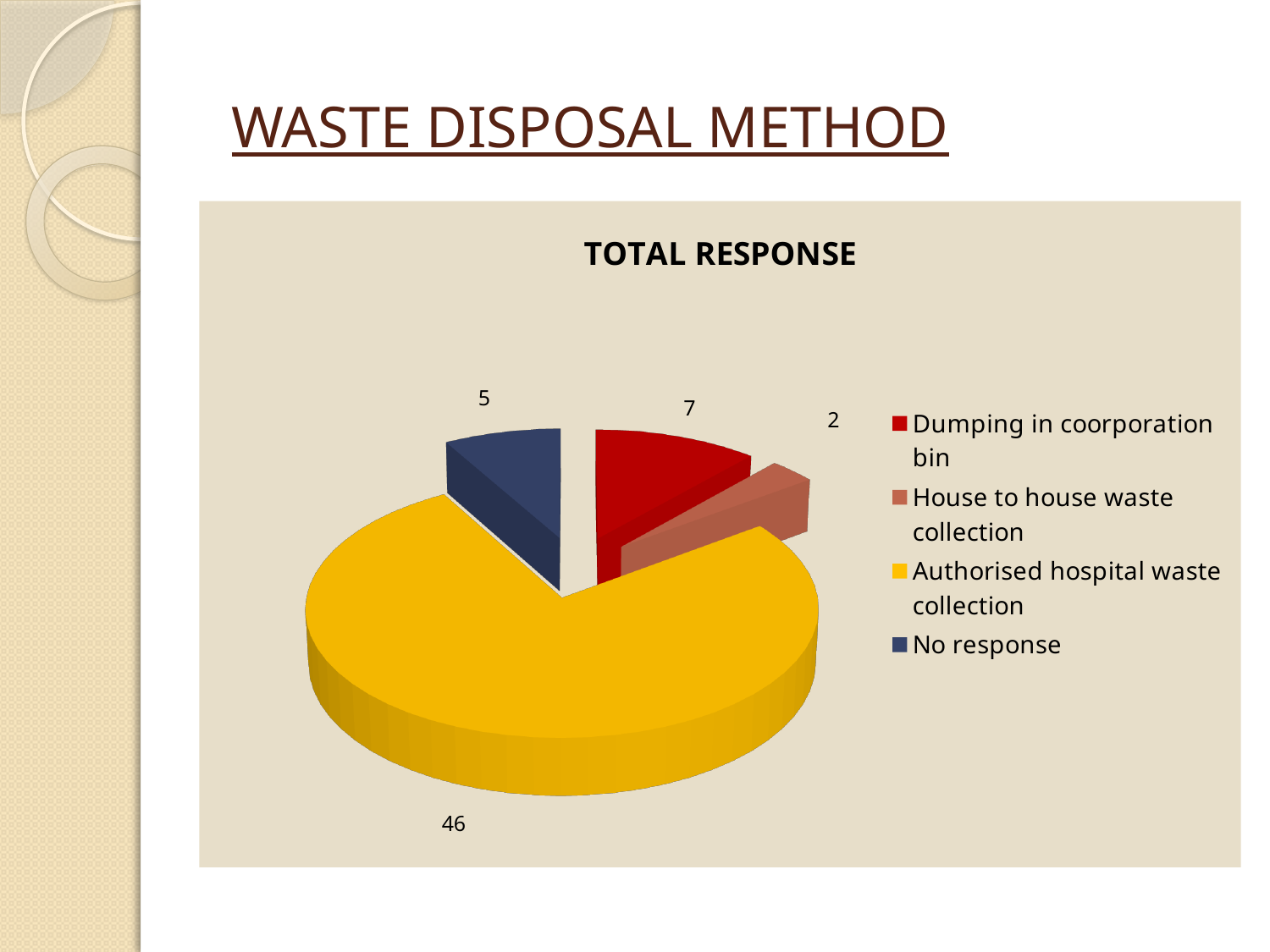
What is the value for No response? 5 What is the value for Dumping in coorporation bin? 7 Which category has the smallest slice of the pie? House to house waste collection What is the value for Authorised hospital waste collection in the TOTAL RESPONSE pie chart? 46 Which category has the largest slice of the pie? Authorised hospital waste collection What is the value for House to house waste collection? 2 What is the title of the chart? TOTAL RESPONSE Which is larger: Dumping in coorporation bin or No response? Dumping in coorporation bin How many categories does the pie chart show? 4 What is the total of all the values shown in the pie chart? 60 What kind of chart is shown on the slide? Pie chart What is the difference between the values for Authorised hospital waste collection and Dumping in coorporation bin? 39